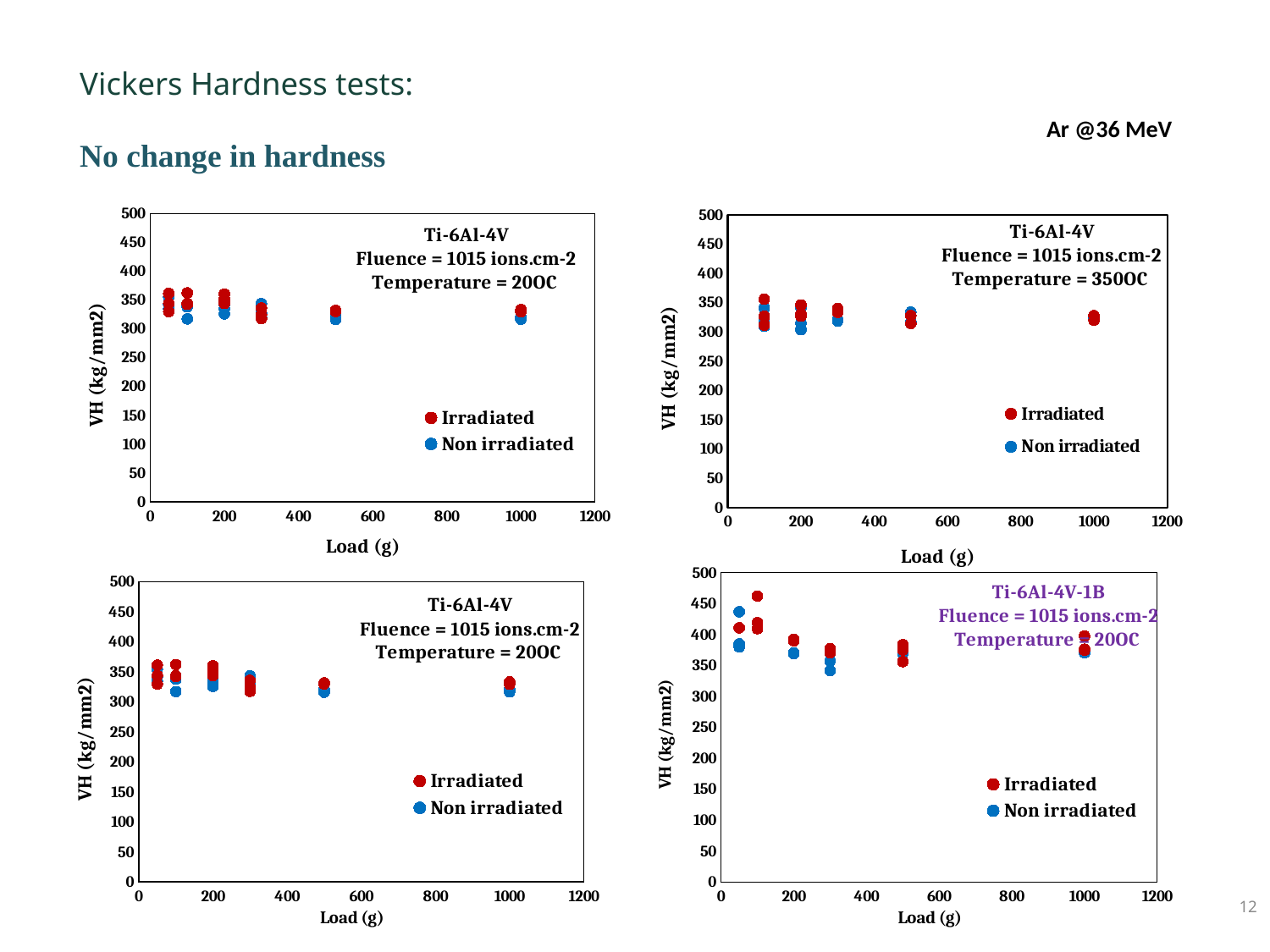
In the bottom-right chart, do the hardness values generally rise or fall as the load increases from 100 g to 1000 g? fall In the bottom-right chart, which series has the highest plotted value, Irradiated or Non irradiated? Irradiated In the top-right chart, are the values at a load of 1000 g greater or less than 300? greater How many series does the legend of the top-left chart list? 2 What kind of chart is the top-left chart? scatter chart How many distinct load levels are plotted in the bottom-right chart? 6 What is the y-axis label of the top-right chart? VH (kg/mm2) In the bottom-right chart, is the highest Irradiated value at a load of 100 g greater or less than 450? greater In the bottom-left chart, are the values at a load of 500 g greater or less than 300? greater What are the two legend entries in the bottom-right chart? Irradiated, Non irradiated